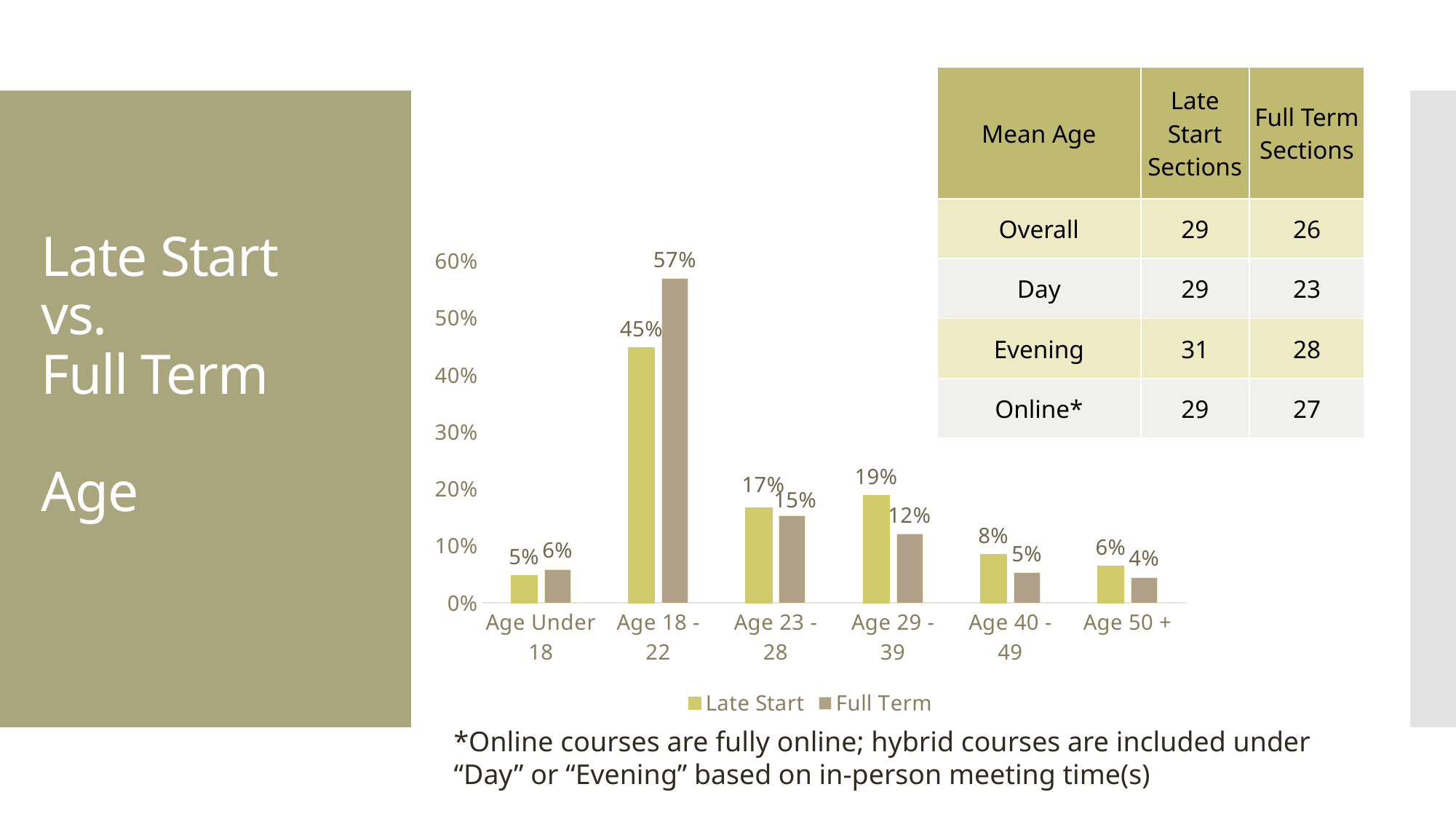
What is the difference between the Full Term and Late Start values for Age 18 - 22? 12% For Age 29 - 39, which series has the larger value, Late Start or Full Term? Late Start What is the Late Start value for Age 18 - 22? 45% How many series does the legend list? 2 What is the Full Term value for Age 29 - 39? 12% Which age category has the highest Full Term value? Age 18 - 22 Which age category has the lowest Full Term value? Age 50 + How many age categories are shown on the x axis? 6 What kind of chart is shown on the slide? bar chart Is the Late Start value for Age 23 - 28 greater or less than 20%? less What are the two series named in the chart legend? Late Start and Full Term What is the Late Start value for Age 50 +? 6%